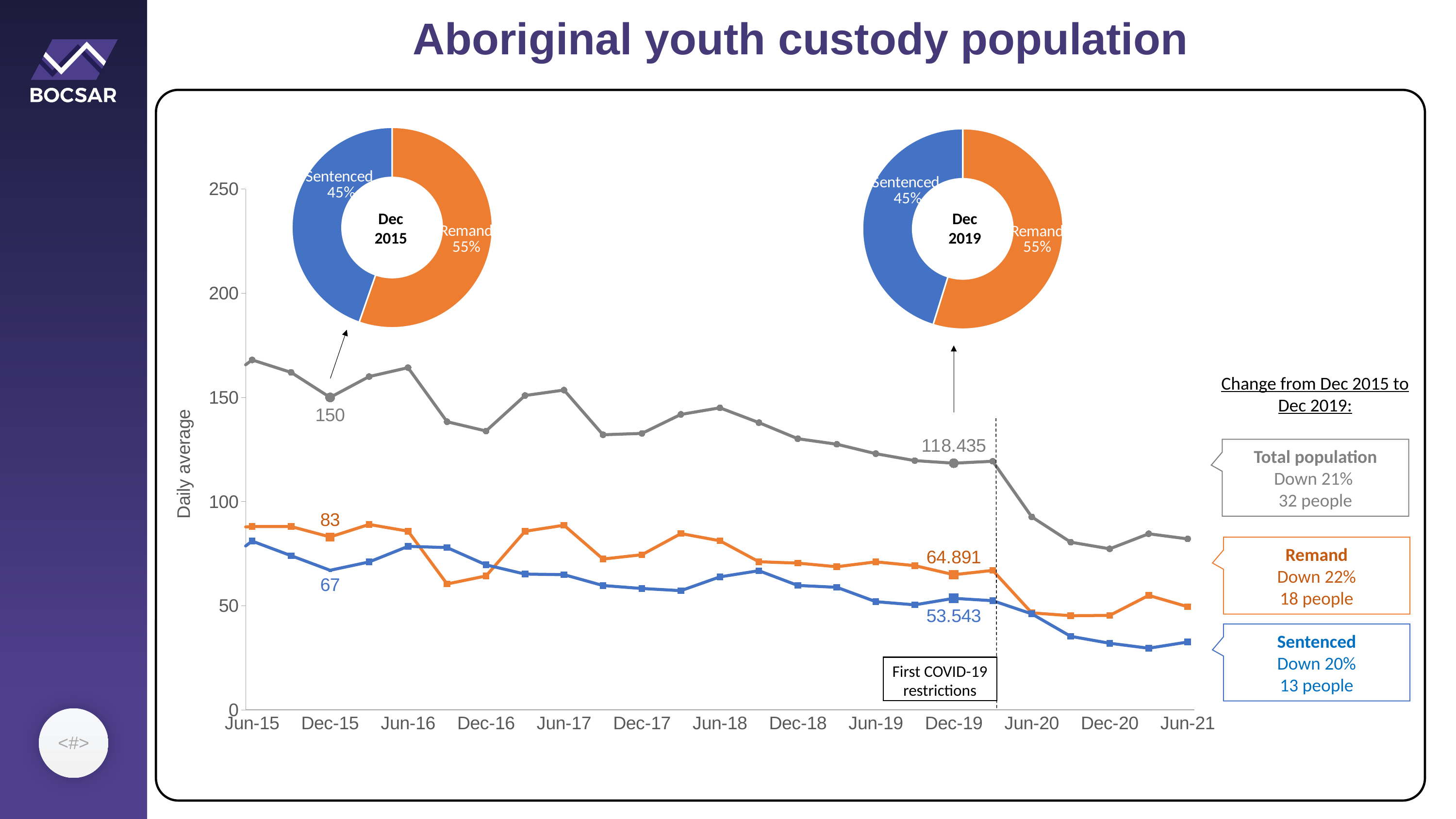
In the Dec 2015 donut chart, what share is Remand? 55% On the line chart, is the Total population value at Jun-21 greater or less than 100? less What is the y-axis title of the line chart? Daily average On the line chart, what is the difference between the labelled Remand and Sentenced values at Dec-15? 16 On the line chart, which is larger at Dec-15: the Remand value or the Sentenced value? Remand On the line chart, is the Total population value at Jun-15 greater or less than 150? greater On the line chart, what is the labelled value of the Total population (grey line) at Dec-15? 150 On the line chart, what is the labelled value of the Sentenced (blue line) at Dec-15? 67 On the line chart, does the Total population line generally rise or fall from Jun-15 to Jun-21? fall In the Dec 2019 donut chart, what share is Sentenced? 45% What kind of chart is the main chart showing daily average over time? line chart On the line chart, what is the labelled value of the Remand (orange line) at Dec-19? 64.891